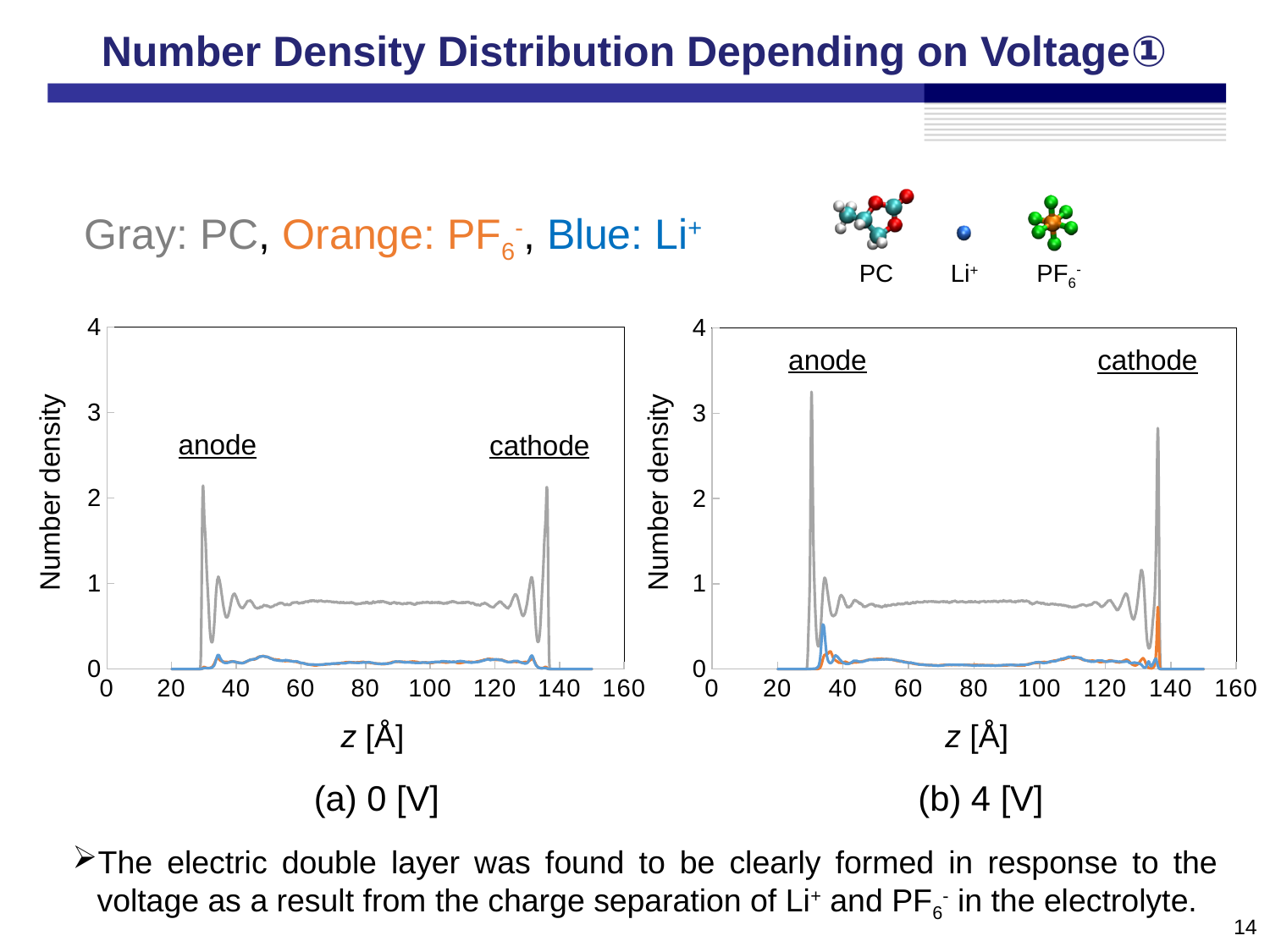
Which colour represents Li+ in the charts? Blue How many series are plotted in each chart according to the colour key on the slide? 3 In chart (b) 4 [V], is the peak of the gray PC curve near the cathode greater or less than 3? less In chart (b) 4 [V], is the orange PF6- peak near the cathode greater or less than 1? less What is the label of the x axis in both charts? z [Å] In chart (b) 4 [V], which gray PC peak is higher, the one near the anode or the one near the cathode? anode In chart (b) 4 [V], which ion shows a peak near the anode, Li+ (blue) or PF6- (orange)? Li+ (blue) What kind of chart is shown in panel (a) 0 [V]? line chart Which chart shows a higher gray PC peak near the anode, (a) 0 [V] or (b) 4 [V]? (b) 4 [V] What is the maximum value shown on the y axis of chart (a) 0 [V]? 4 In chart (b) 4 [V], is the peak of the gray PC curve near the anode greater or less than 3? greater